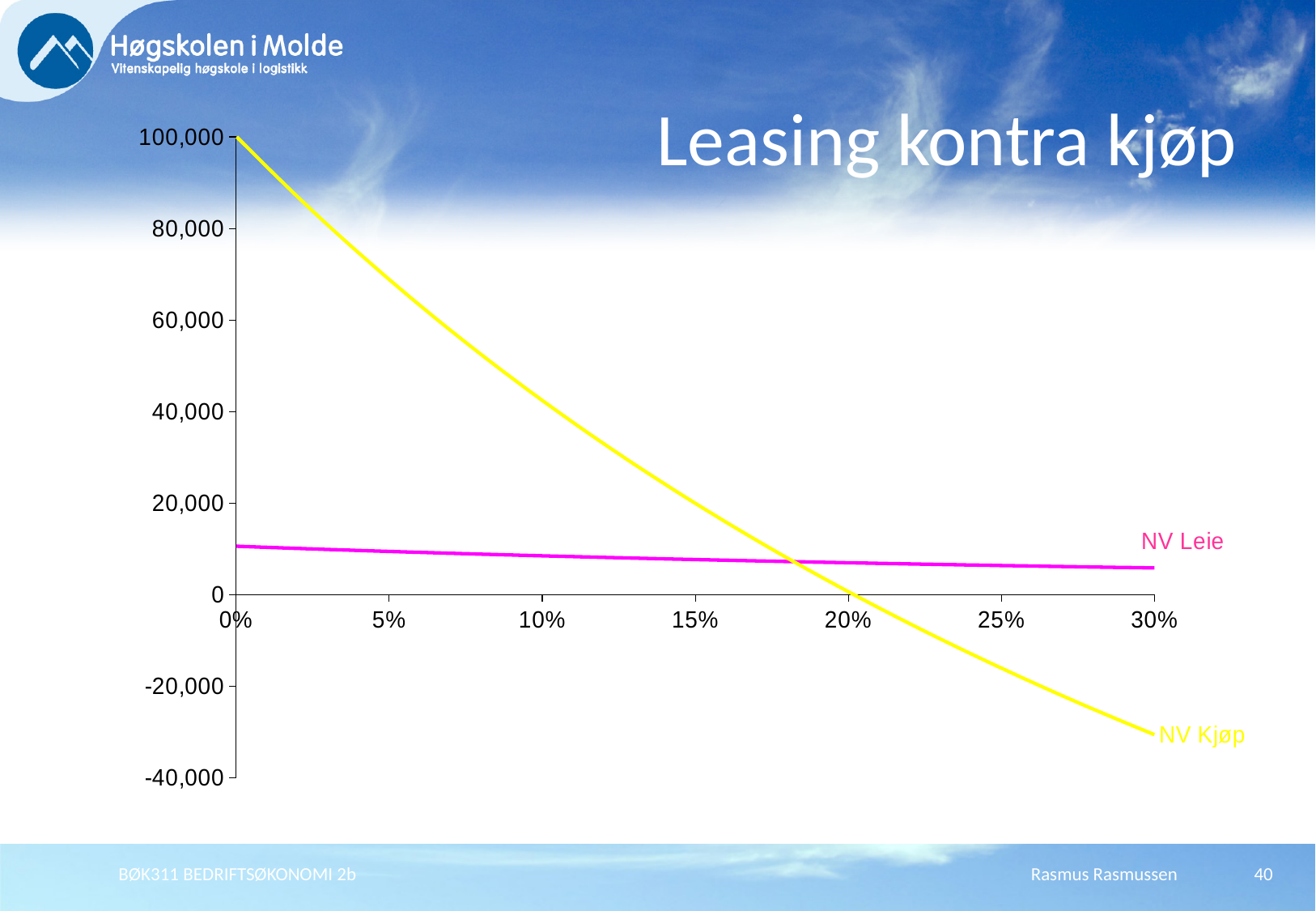
Is the value of NV Kjøp at 5% greater or less than 60,000? greater How many series are plotted on the chart? 2 Does NV Kjøp rise or fall as the rate on the x axis increases? fall At 10%, which series has the higher value, NV Leie or NV Kjøp? NV Kjøp Is the value of NV Leie at 0% greater or less than 20,000? less At 25%, which series has the higher value, NV Leie or NV Kjøp? NV Leie What kind of chart is shown on the slide? line chart What is the title of the slide's chart? Leasing kontra kjøp Does NV Leie rise or fall as the rate on the x axis increases? fall Is the value of NV Kjøp at 30% greater or less than -20,000? less